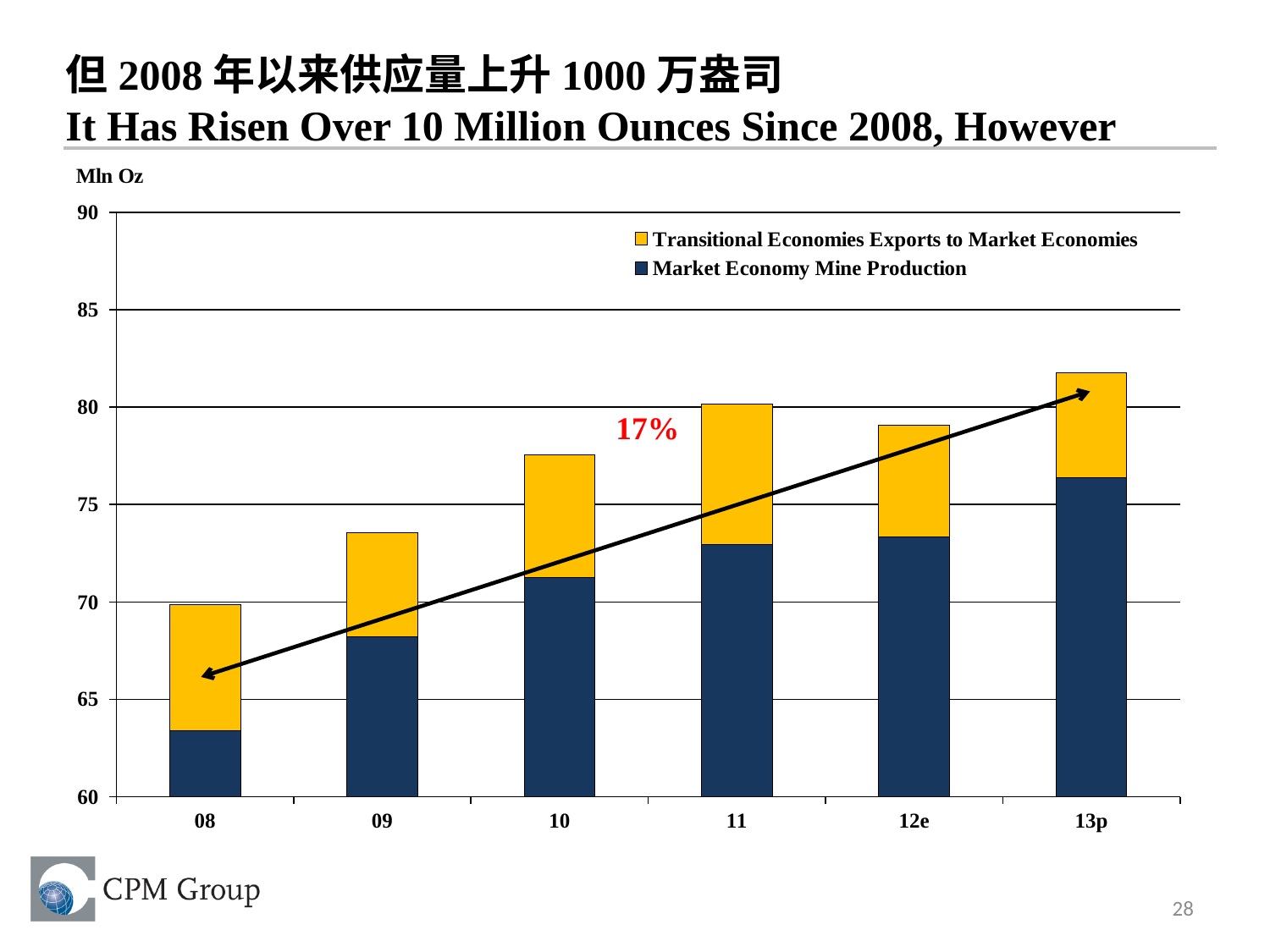
Is the Market Economy Mine Production value for 08 greater or less than 65? less Is the total bar for 13p greater or less than 80? greater Which year has the lowest total bar? 08 Do the total bar heights generally rise or fall from 08 to 13p? Rise What percentage is annotated next to the arrow on the chart? 17% What kind of chart is shown on the slide? Stacked bar chart Which year has the highest total bar? 13p Is the total bar for 10 greater or less than 75? greater Which is larger, the total bar for 10 or the total bar for 11? 11 How many years (categories) are shown on the x axis? 6 How many series does the legend list? 2